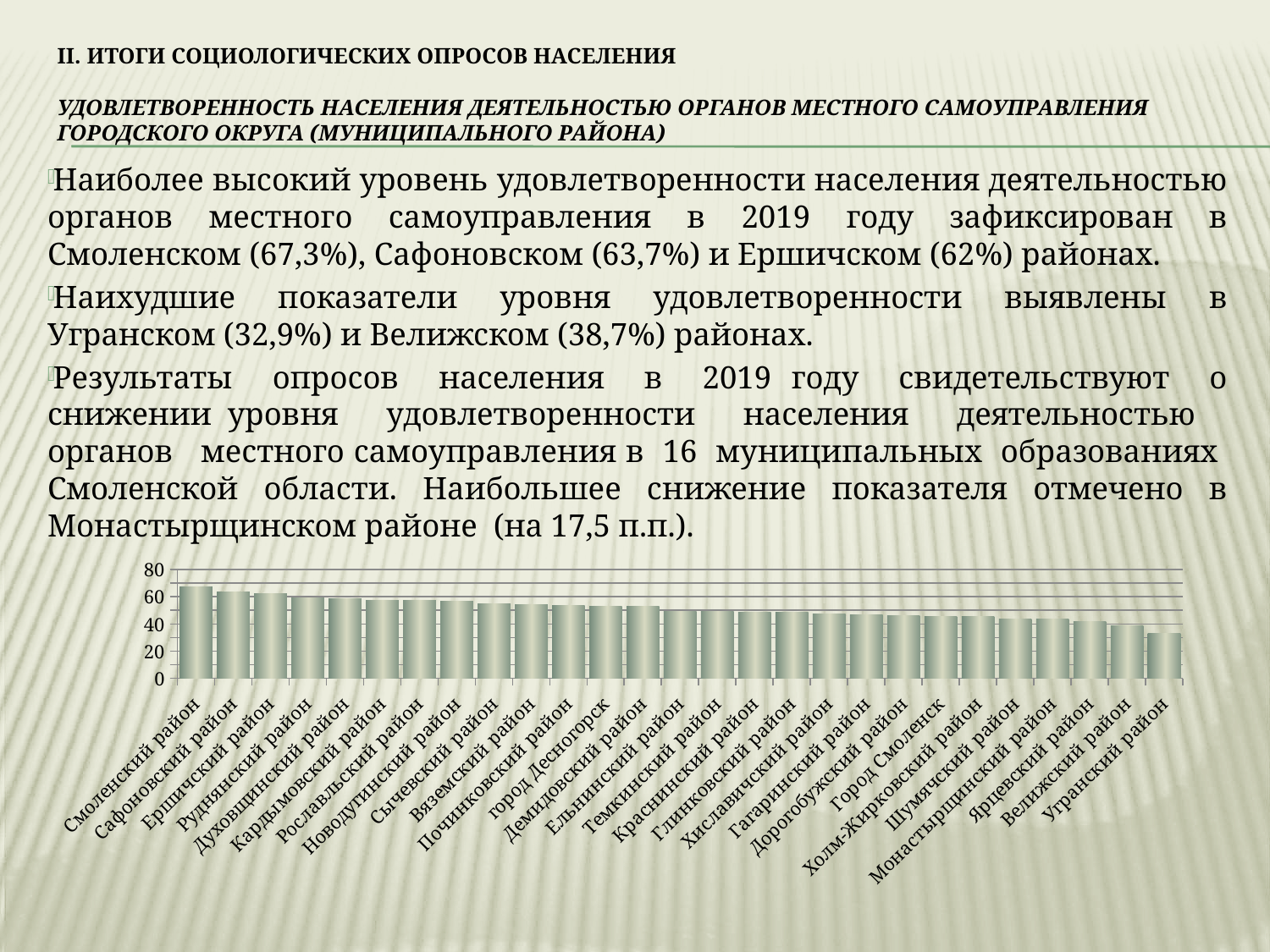
Is the value for Угранский район greater or less than 40? less Which category has the lowest bar on the chart? Угранский район Do the bar values rise or fall from left to right along the x axis? fall Is the value for Вяземский район greater or less than 60? less What kind of chart is shown on the slide? bar chart Which has the larger value, Сафоновский район or Велижский район? Сафоновский район How many categories (municipalities) are plotted on the chart? 27 Is the value for Гагаринский район greater or less than 40? greater Which category has the highest bar on the chart? Смоленский район What is the highest tick value shown on the vertical axis? 80 Which has the larger value, город Смоленск or Рославльский район? Рославльский район